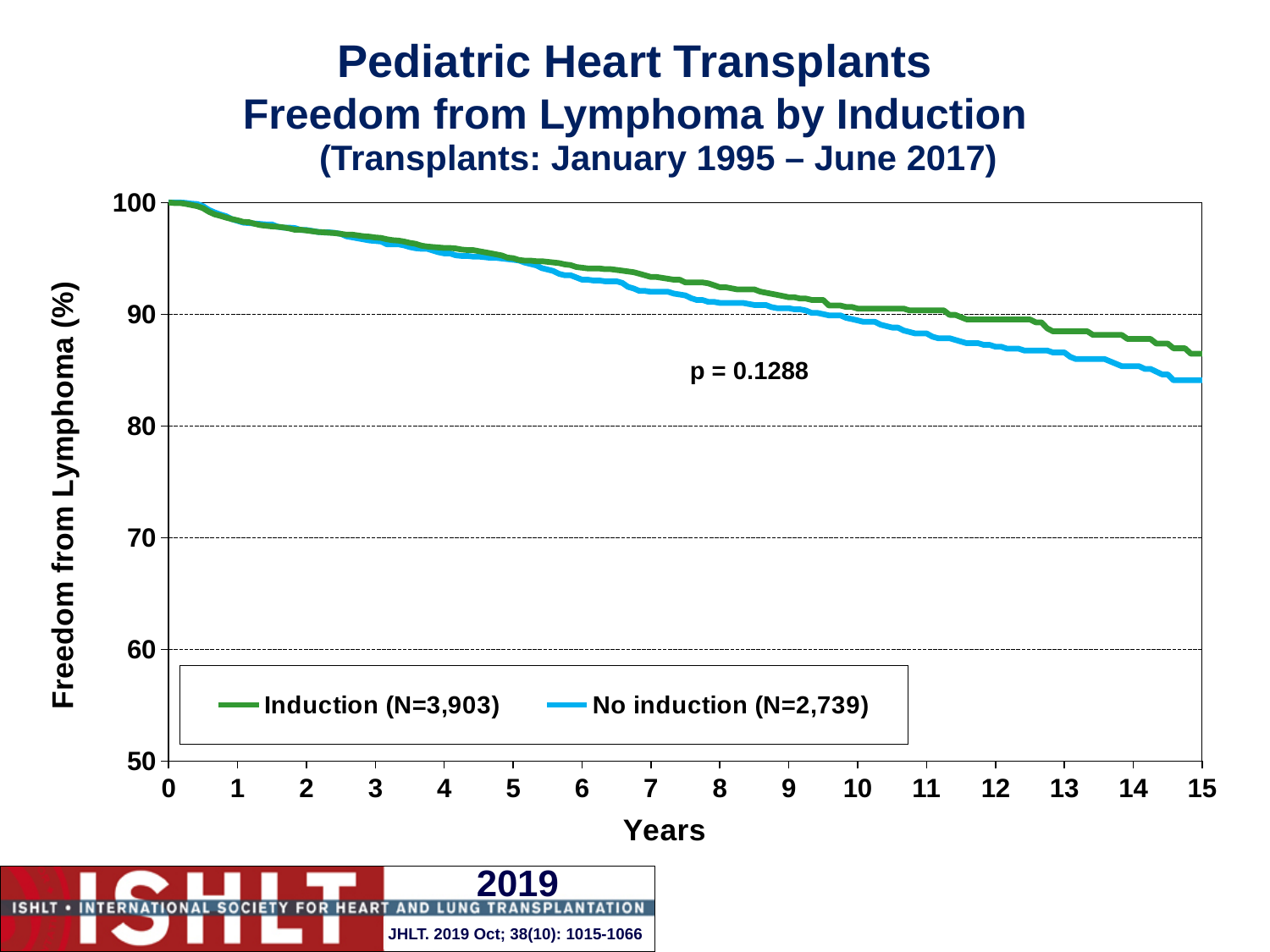
Is the value for Induction at 5 years greater or less than 90? greater At 15 years, which series has the higher freedom from lymphoma, Induction or No induction? Induction What p-value is shown on the chart? p = 0.1288 What kind of chart is shown on the slide? line chart Is the value for No induction at 15 years greater or less than 80? greater What is the N for the Induction group shown in the legend? N=3,903 Is the value for Induction at 15 years greater or less than 90? less At 12 years, which series has the higher freedom from lymphoma, Induction or No induction? Induction How many series does the legend list? 2 Do the values for the Induction series rise or fall as years increase? fall Do the values for the No induction series rise or fall as years increase? fall